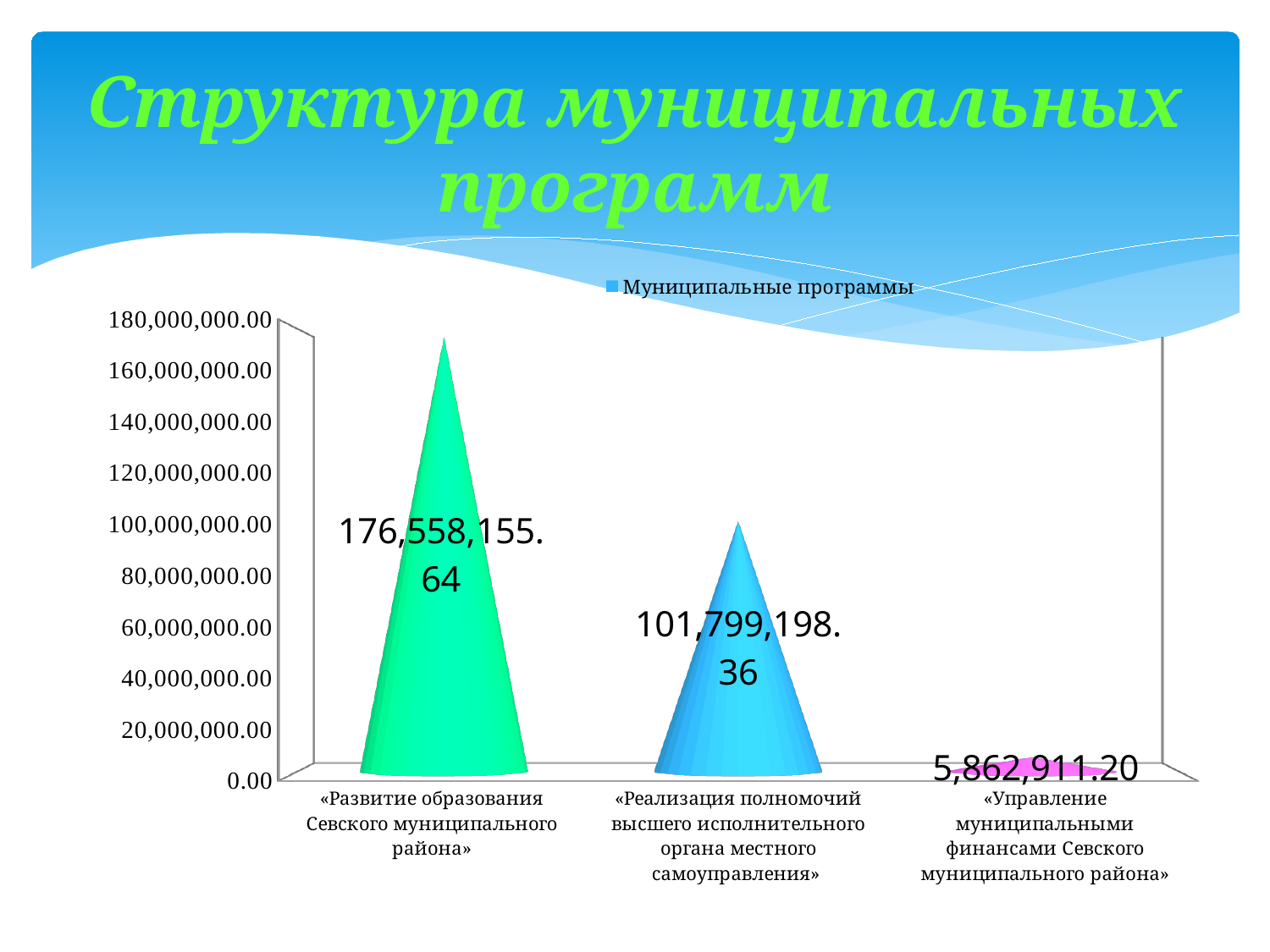
Is the value for «Реализация полномочий высшего исполнительного органа местного самоуправления» greater or less than 100,000,000.00? greater What is the value for «Развитие образования Севского муниципального района»? 176,558,155.64 What kind of chart is shown on the slide? bar chart Which category has the highest value? «Развитие образования Севского муниципального района» How many series does the legend list? 1 How many categories are shown on the chart? 3 What is the value for «Реализация полномочий высшего исполнительного органа местного самоуправления»? 101,799,198.36 Which is larger: the value for «Реализация полномочий высшего исполнительного органа местного самоуправления» or for «Управление муниципальными финансами Севского муниципального района»? «Реализация полномочий высшего исполнительного органа местного самоуправления» What is the difference between the values for «Развитие образования Севского муниципального района» and «Реализация полномочий высшего исполнительного органа местного самоуправления»? 74,758,957.28 Which category has the lowest value? «Управление муниципальными финансами Севского муниципального района» What is the name of the series shown in the legend? Муниципальные программы What is the value for «Управление муниципальными финансами Севского муниципального района»? 5,862,911.20